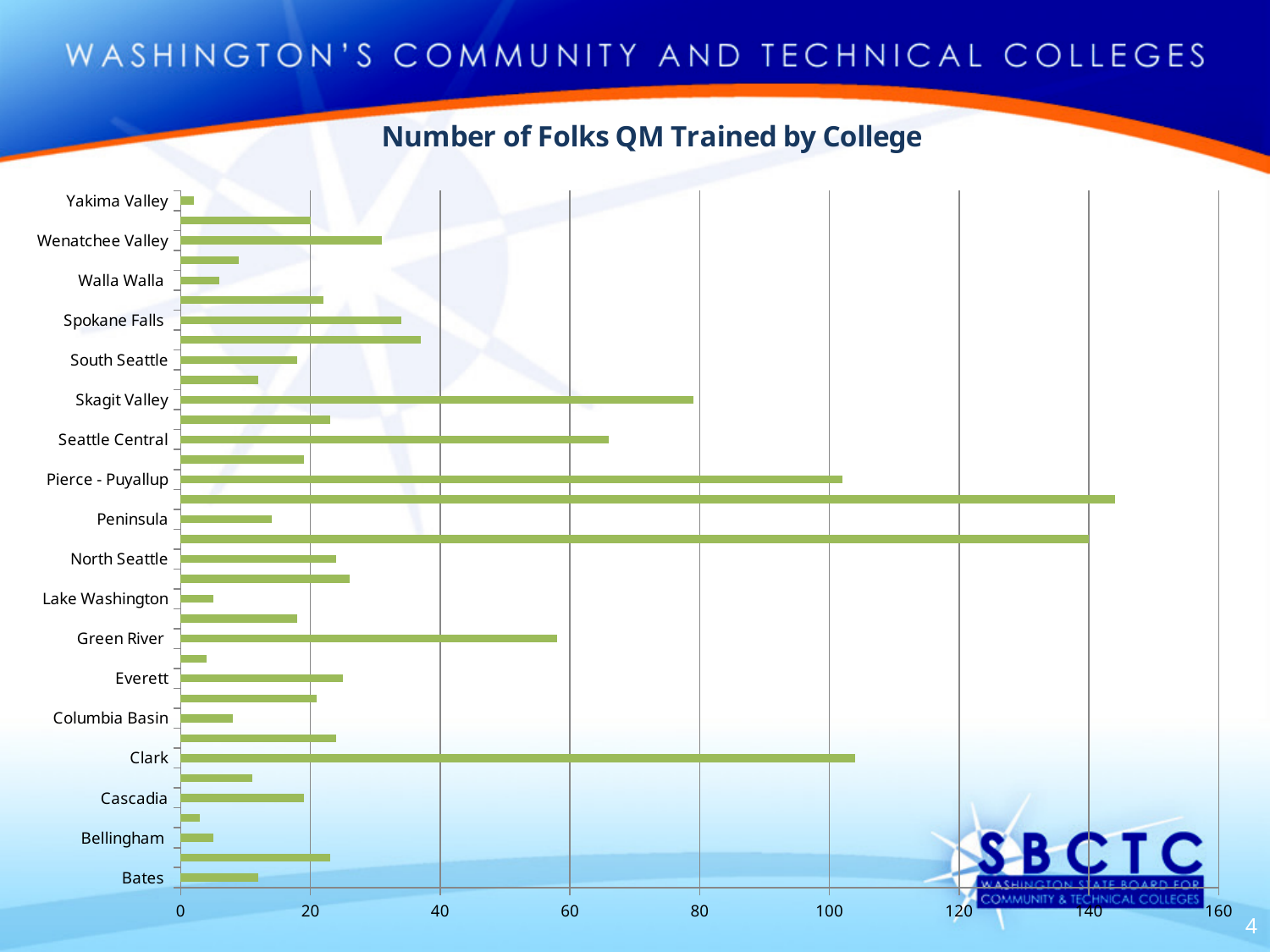
Which has a larger value, Wenatchee Valley or Walla Walla? Wenatchee Valley Is the value for Yakima Valley greater or less than 20? less Is the value for Peninsula greater or less than 20? less Is the value for Wenatchee Valley greater or less than 20? greater What is the highest value shown on the horizontal axis? 160 Which has a larger value, Skagit Valley or Seattle Central? Skagit Valley What is the title of the chart? Number of Folks QM Trained by College What kind of chart is shown on the slide? bar chart Which has a larger value, Green River or Everett? Green River